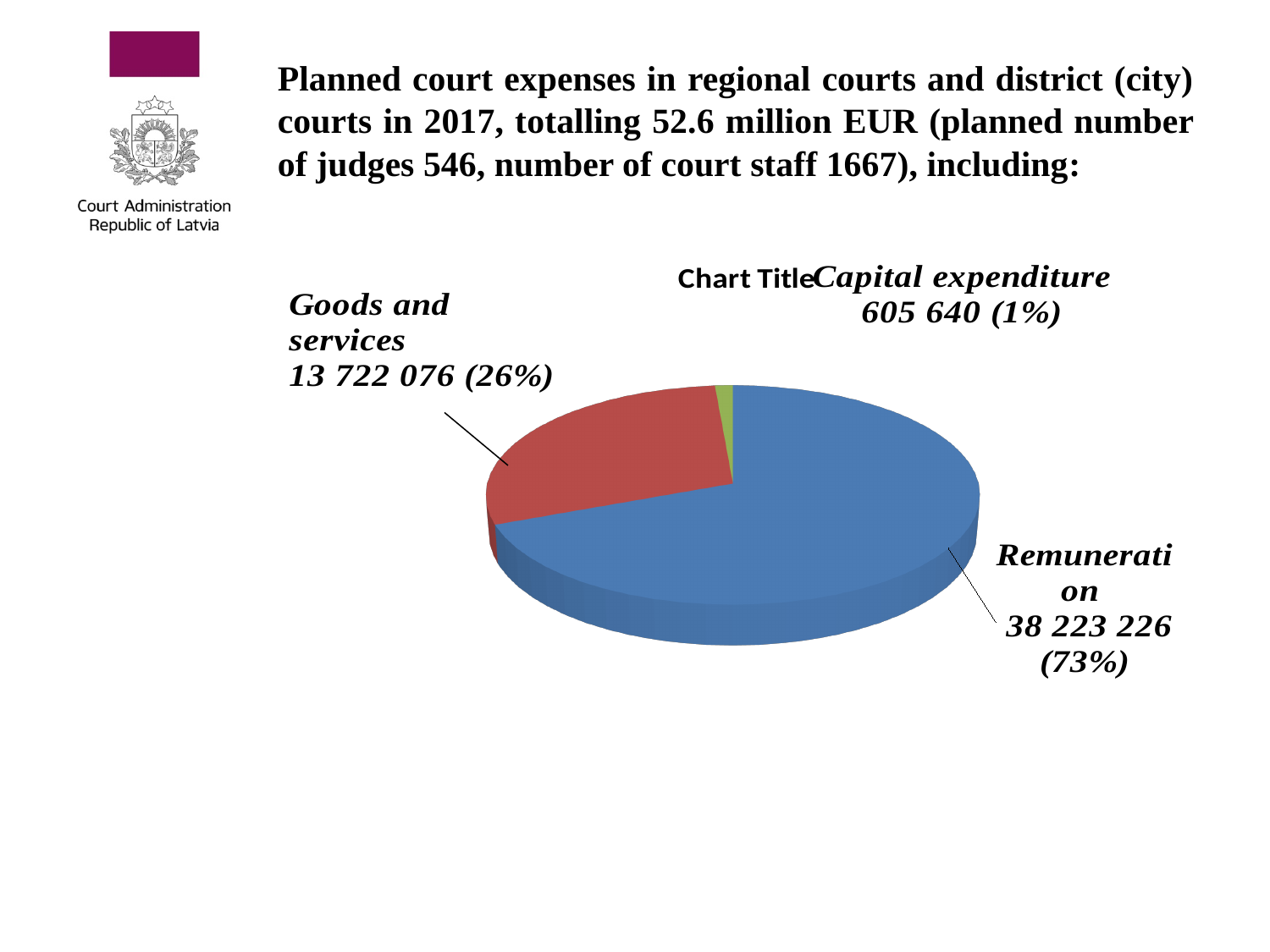
What kind of chart is shown on the slide? pie chart What is the planned amount for Goods and services? 13 722 076 What is the planned amount for Remuneration? 38 223 226 What share of the pie does Remuneration represent? 73% What colour is the Remuneration slice? blue Which category has the largest slice of the pie? Remuneration What share of the pie does Goods and services represent? 26% Which is larger, Goods and services or Capital expenditure? Goods and services What share of the pie does Capital expenditure represent? 1% Which category has the smallest slice of the pie? Capital expenditure What is the planned amount for Capital expenditure? 605 640 How many slices does the pie chart have? 3